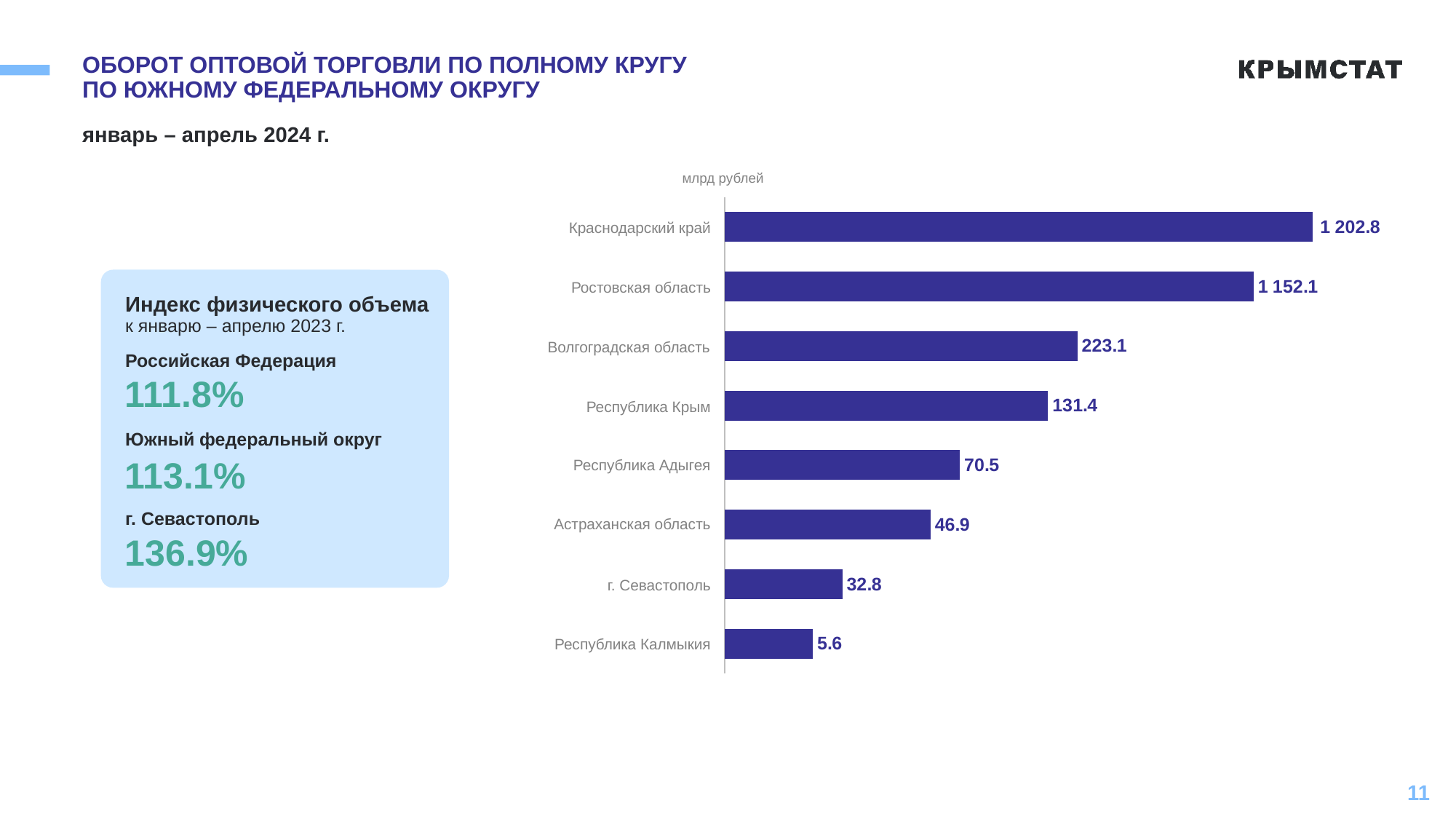
What is the difference between Волгоградская область and Республика Крым? 91.7 What is the value for г. Севастополь? 32.8 What is the value for Республика Крым? 131.4 Which region has the highest value? Краснодарский край What kind of chart is shown on the slide? bar chart Do the values rise or fall going from the top bar to the bottom bar? fall Which region has the lowest value? Республика Калмыкия What is the value for Краснодарский край? 1 202.8 What is the difference between Краснодарский край and Ростовская область? 50.7 How many regions are shown in the chart? 8 What unit is shown above the chart? млрд рублей Which is larger, the value for Республика Адыгея or Астраханская область? Республика Адыгея